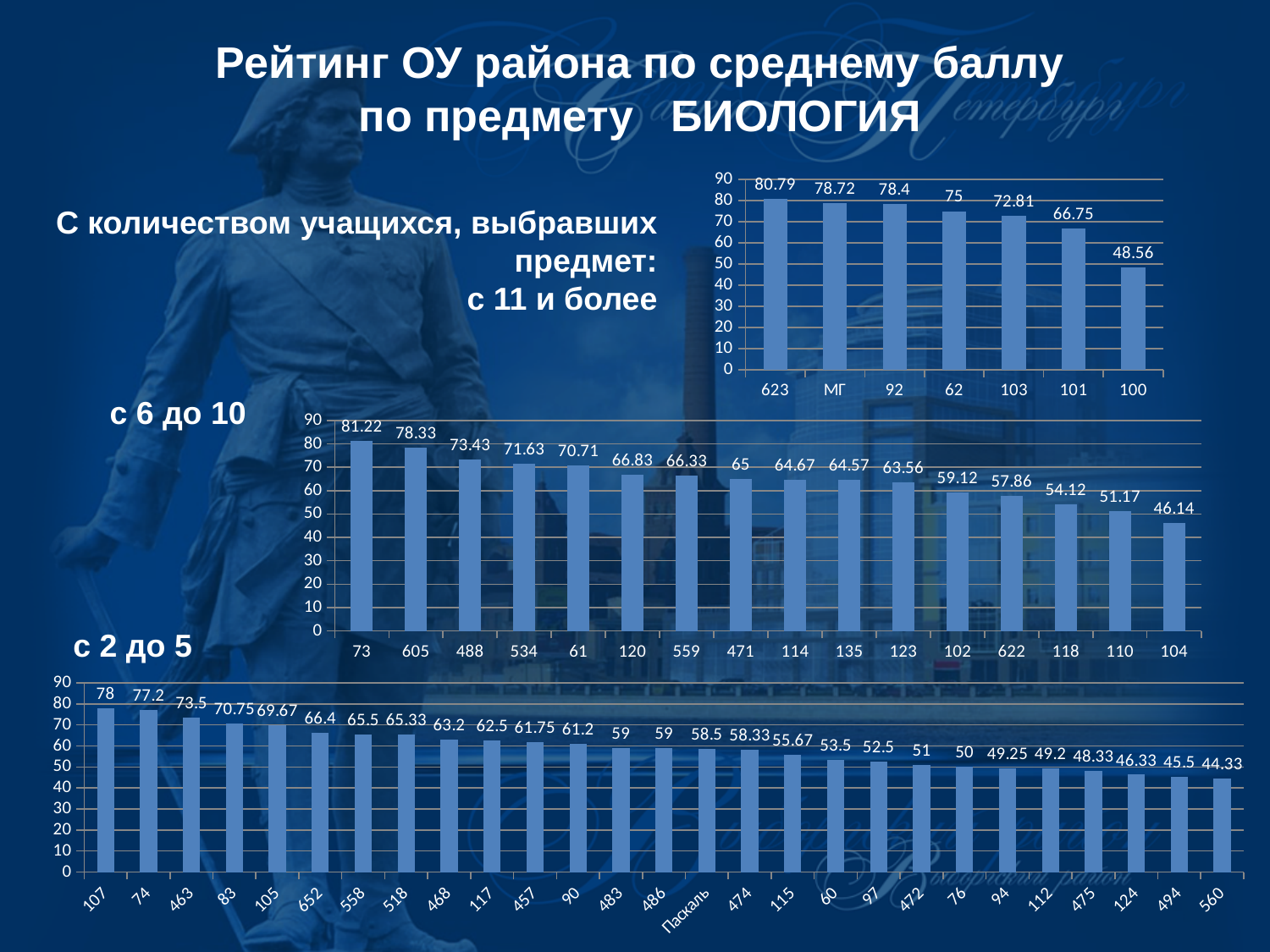
In the middle chart (с 6 до 10), which is larger: the value for 102 or the value for 118? 102 What type of chart is the bottom chart (с 2 до 5)? bar chart In the top-right chart (с 11 и более), what is the difference between the values for 623 and 100? 32.23 In the bottom chart (с 2 до 5), what is the value for Паскаль? 58.5 In the middle chart (с 6 до 10), how many categories are shown? 16 In the top-right chart (с 11 и более), what is the value for school 623? 80.79 In the middle chart (с 6 до 10), what is the value for school 534? 71.63 In the bottom chart (с 2 до 5), which category has the lowest value? 560 In the top-right chart (с 11 и более), which category has the lowest value? 100 In the middle chart (с 6 до 10), which category has the highest value? 73 In the bottom chart (с 2 до 5), do the values rise or fall from left to right? fall In the top-right chart (с 11 и более), how many categories are shown? 7